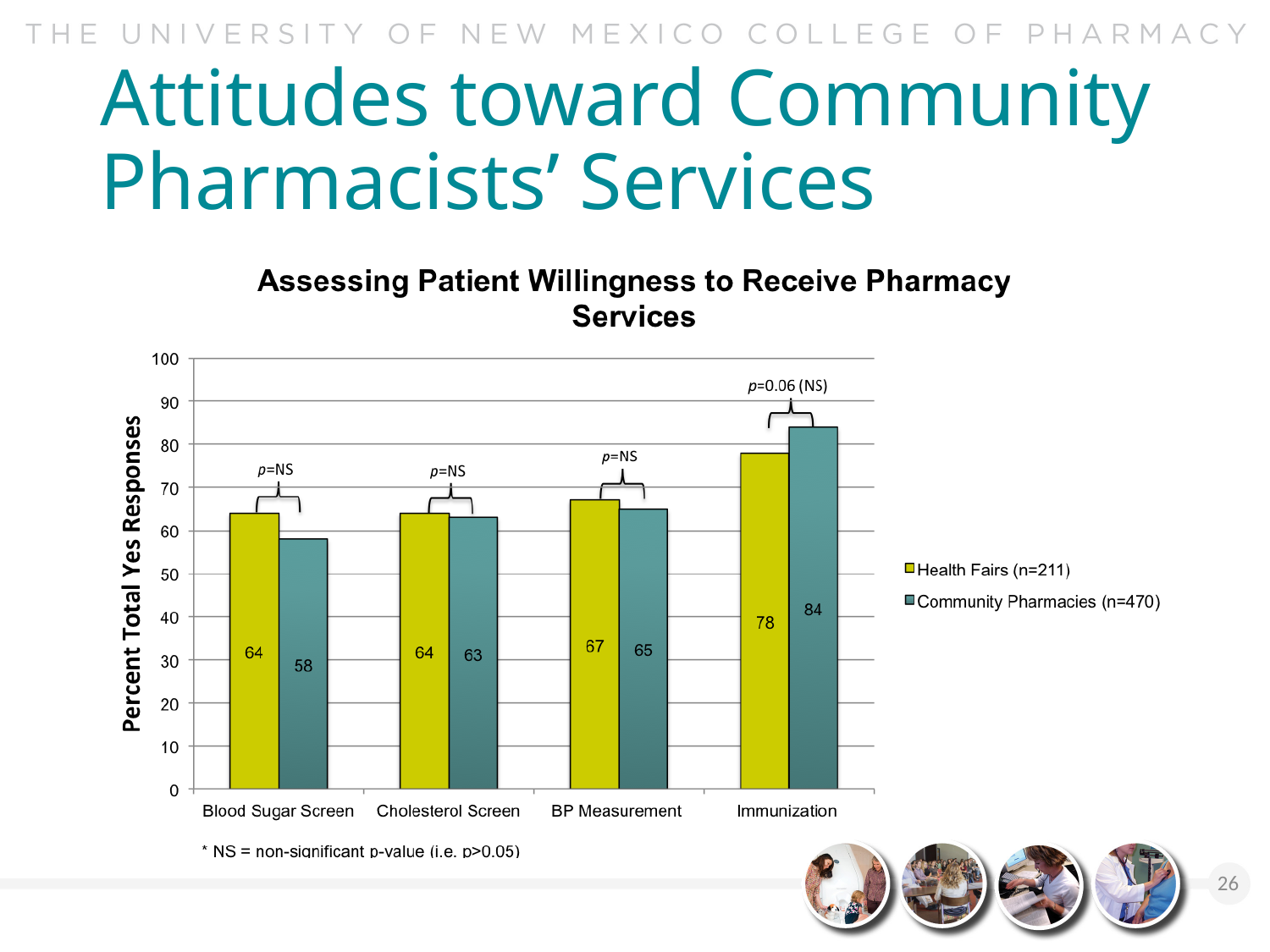
What is the value for Community Pharmacies for BP Measurement? 65 What is the value for Community Pharmacies for Immunization? 84 Which category has the lowest value for Community Pharmacies? Blood Sugar Screen What kind of chart is shown? bar chart What is the difference between the Health Fairs and Community Pharmacies values for Blood Sugar Screen? 6 For Immunization, which series has the larger value, Health Fairs or Community Pharmacies? Community Pharmacies Which category has the highest value for Community Pharmacies? Immunization How many categories are shown on the x axis? 4 What is the title of the chart? Assessing Patient Willingness to Receive Pharmacy Services What is the value for Health Fairs for Blood Sugar Screen? 64 Is the value for Health Fairs for Immunization greater or less than 70? greater How many series does the legend list? 2